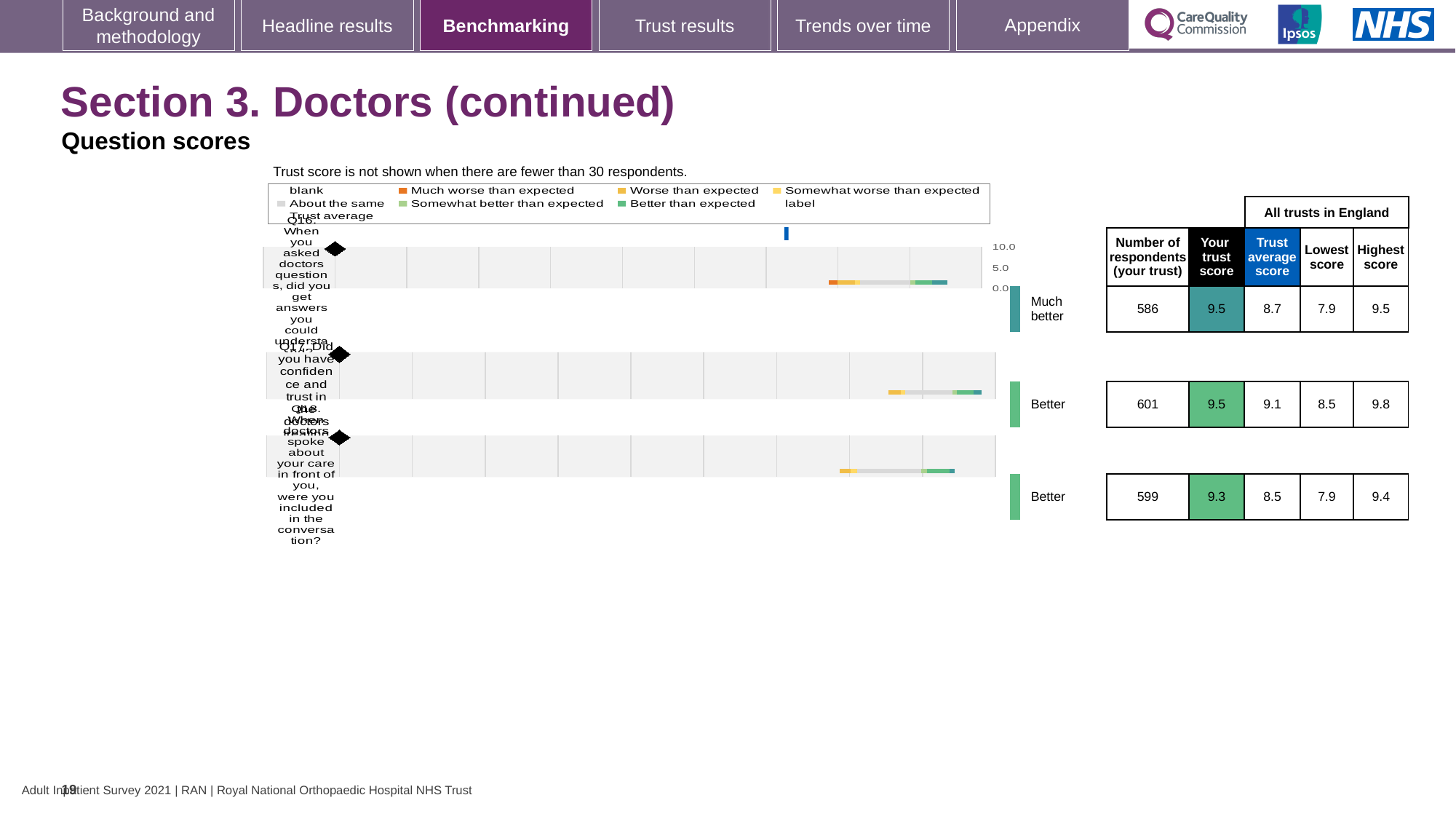
Which question has the lowest trust score? Q18 How many questions (categories) are plotted in the chart? 3 What is the trust score for Q16 (when you asked doctors questions, did you get answers you could understand)? 9.5 Which is larger: the highest score for Q17 or the highest score for Q16? Q17 What kind of chart is used to show the question scores on this slide? bar chart What is the number of respondents for Q18 (were you included in the conversation when doctors spoke about your care)? 599 What benchmark category label is shown next to Q16? Much better What is the difference between the trust score and the trust average score for Q16? 0.8 What is the lowest score across all trusts in England for Q18? 7.9 Which question has the highest number of respondents? Q17 What is the highest score across all trusts in England for Q17? 9.8 What is the trust average score for Q17 (confidence and trust in the doctors treating you)? 9.1